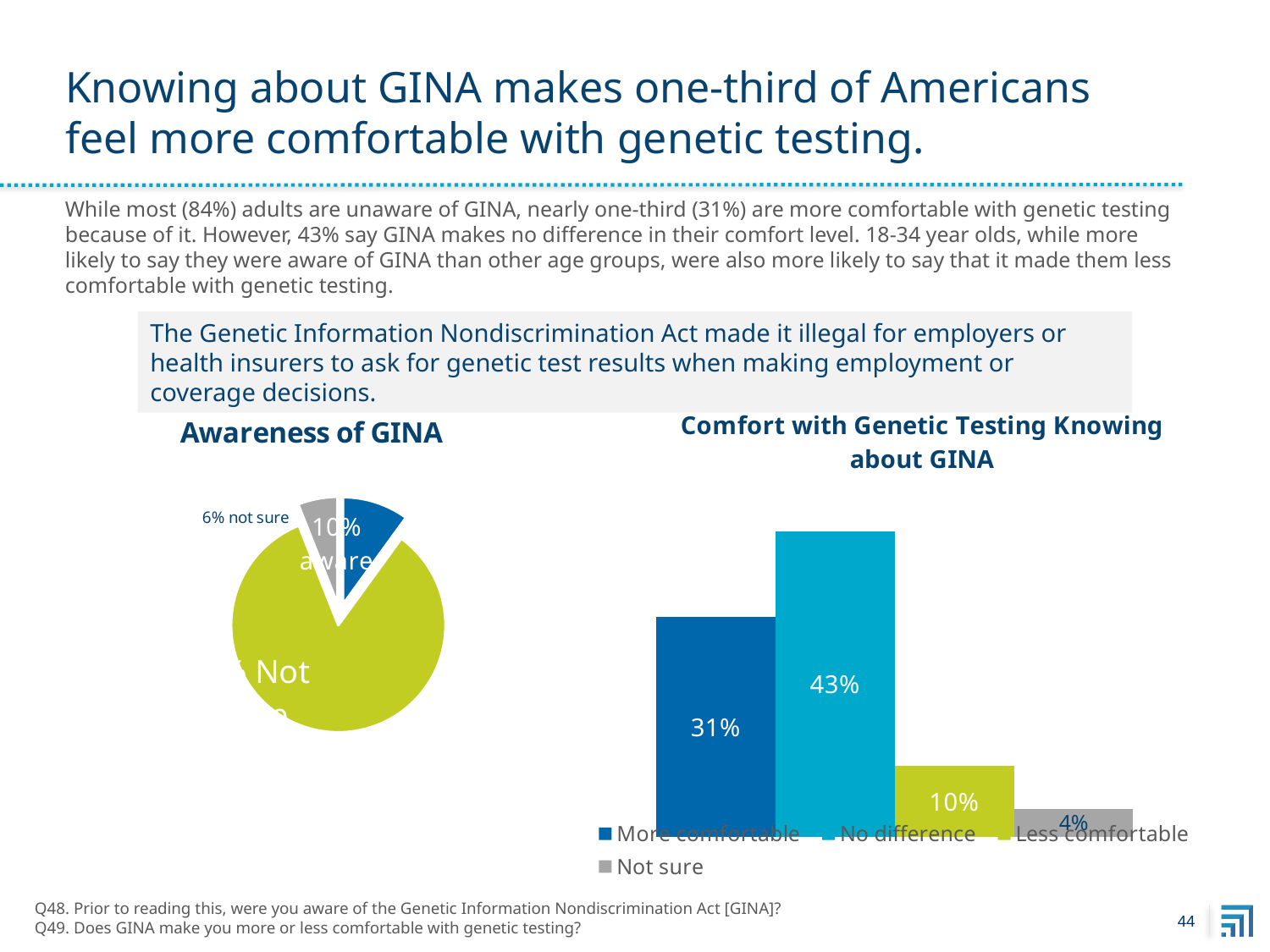
In the 'Comfort with Genetic Testing Knowing about GINA' chart, what is the value for 'Not sure'? 4% What kind of chart is the 'Awareness of GINA' chart? Pie chart In the 'Comfort with Genetic Testing Knowing about GINA' chart, what percentage say GINA makes no difference? 43% In the 'Comfort with Genetic Testing Knowing about GINA' chart, which is larger: 'Less comfortable' or 'Not sure'? Less comfortable In the 'Comfort with Genetic Testing Knowing about GINA' chart, which response has the lowest value? Not sure In the 'Comfort with Genetic Testing Knowing about GINA' chart, which response has the highest value? No difference In the 'Comfort with Genetic Testing Knowing about GINA' chart, what is the value for 'More comfortable'? 31% What kind of chart is the 'Comfort with Genetic Testing Knowing about GINA' chart? Bar chart In the 'Awareness of GINA' pie chart, what percentage are 'not sure'? 6% In the 'Comfort with Genetic Testing Knowing about GINA' chart, what is the value for 'Less comfortable'? 10% How many entries does the legend of the 'Comfort with Genetic Testing Knowing about GINA' chart list? 4 In the 'Comfort with Genetic Testing Knowing about GINA' chart, what is the difference between 'No difference' and 'More comfortable'? 12%